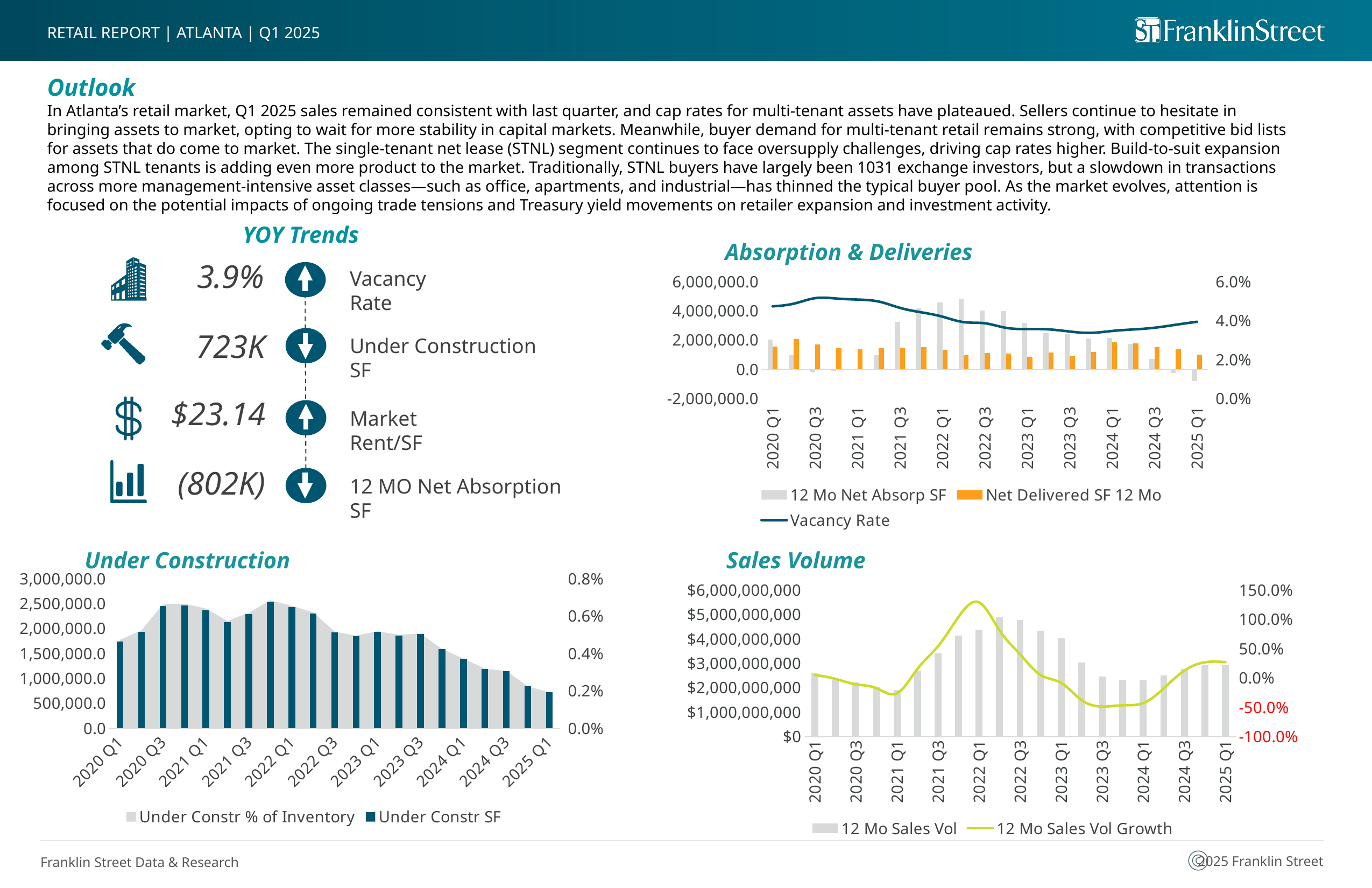
In the Absorption & Deliveries chart, is the 12 Mo Net Absorp SF value for 2022 Q1 greater or less than 4,000,000.0? greater In the Sales Volume chart, is the 12 Mo Sales Vol Growth value for 2023 Q3 greater or less than 0.0%? less In the Under Construction chart, does Under Constr SF rise or fall from 2022 Q1 to 2025 Q1? fall In the Under Construction chart, what kind of chart is used for the Under Constr SF series? bar chart In the Under Construction chart, which quarter has the lowest Under Constr SF value? 2025 Q1 In the Sales Volume chart, is the 12 Mo Sales Vol value for 2020 Q1 greater or less than $2,000,000,000? greater In the Absorption & Deliveries chart, which series is drawn as a line rather than bars? Vacancy Rate In the Absorption & Deliveries chart, how many series does the legend list? 3 In the Sales Volume chart, which series is shown as a line? 12 Mo Sales Vol Growth In the Under Construction chart, how many series does the legend list? 2